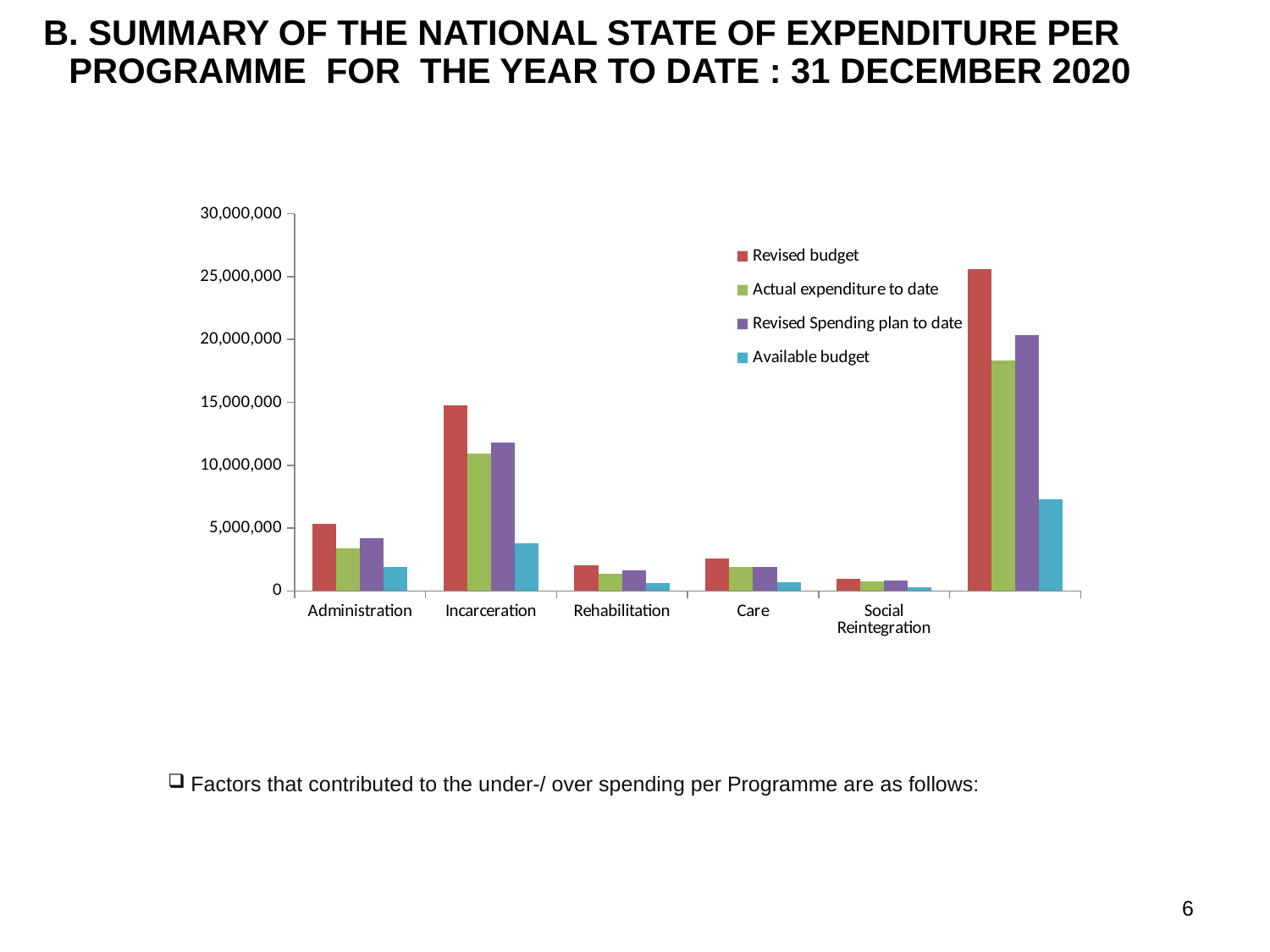
Is the Revised budget value for Incarceration greater or less than 10,000,000? greater Is the Available budget value for Incarceration greater or less than 5,000,000? less Among the labelled programmes on the x axis, which has the lowest Revised budget? Social Reintegration What kind of chart is shown on the slide? Bar chart Which series is shown in blue in the legend? Available budget Is the Revised Spending plan to date value for Incarceration greater or less than 10,000,000? greater How many series does the legend list? 4 For Administration, which is larger: the Revised budget or the Available budget? Revised budget What is the highest value shown on the vertical axis? 30,000,000 Among the labelled programmes on the x axis, which has the highest Revised budget? Incarceration